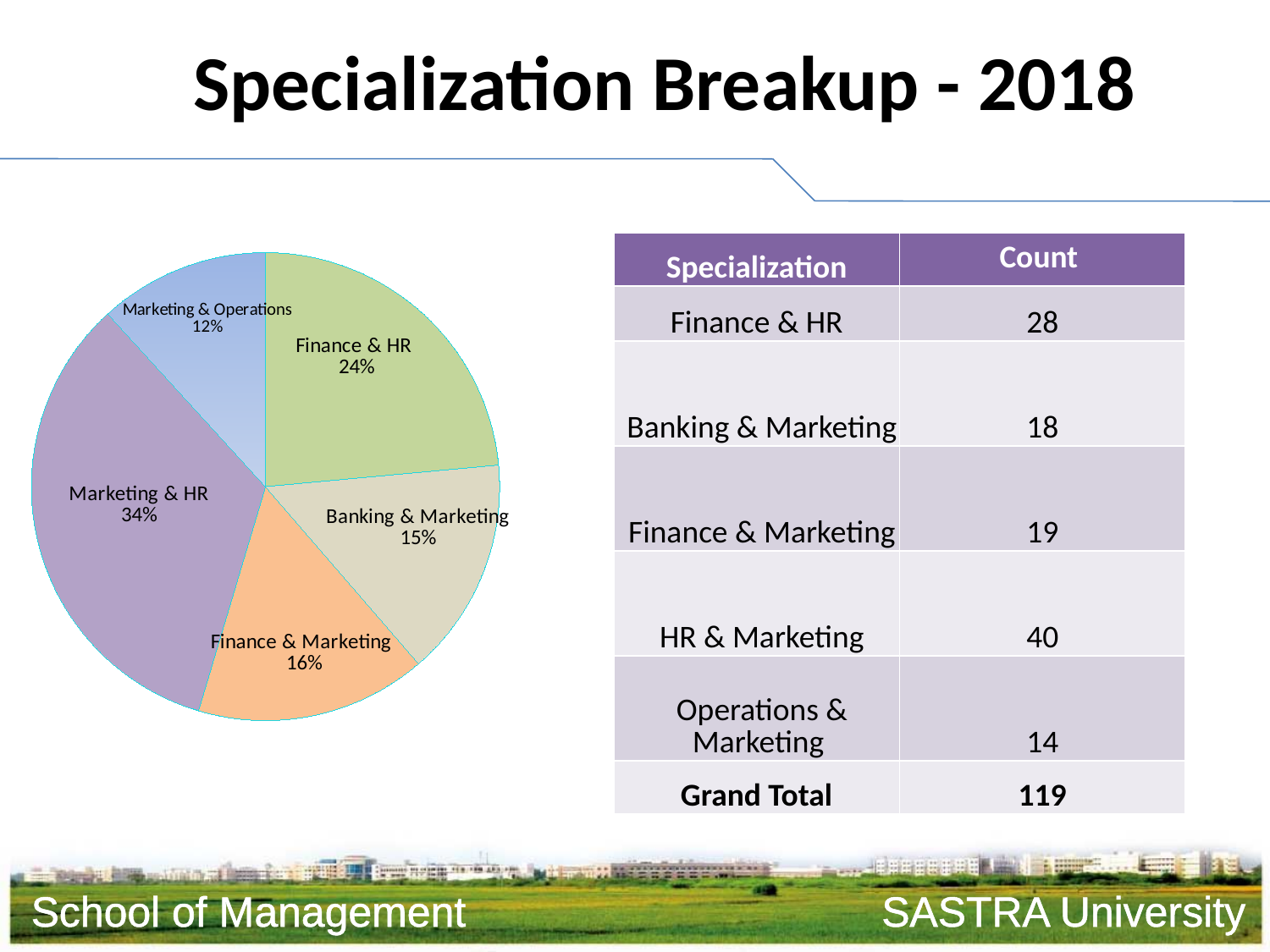
Which specialization has the largest slice of the pie? Marketing & HR Which slice is larger, Finance & Marketing or Marketing & Operations? Finance & Marketing What share of the pie does Finance & Marketing represent? 16% What share of the pie does Marketing & Operations represent? 12% How many slices does the pie chart have? 5 What is the difference in percentage points between the Marketing & HR slice and the Finance & HR slice? 10% What is the title of the slide containing the pie chart? Specialization Breakup - 2018 Which specialization has the smallest slice of the pie? Marketing & Operations What share of the pie does Banking & Marketing represent? 15% What kind of chart is shown on the slide? Pie chart